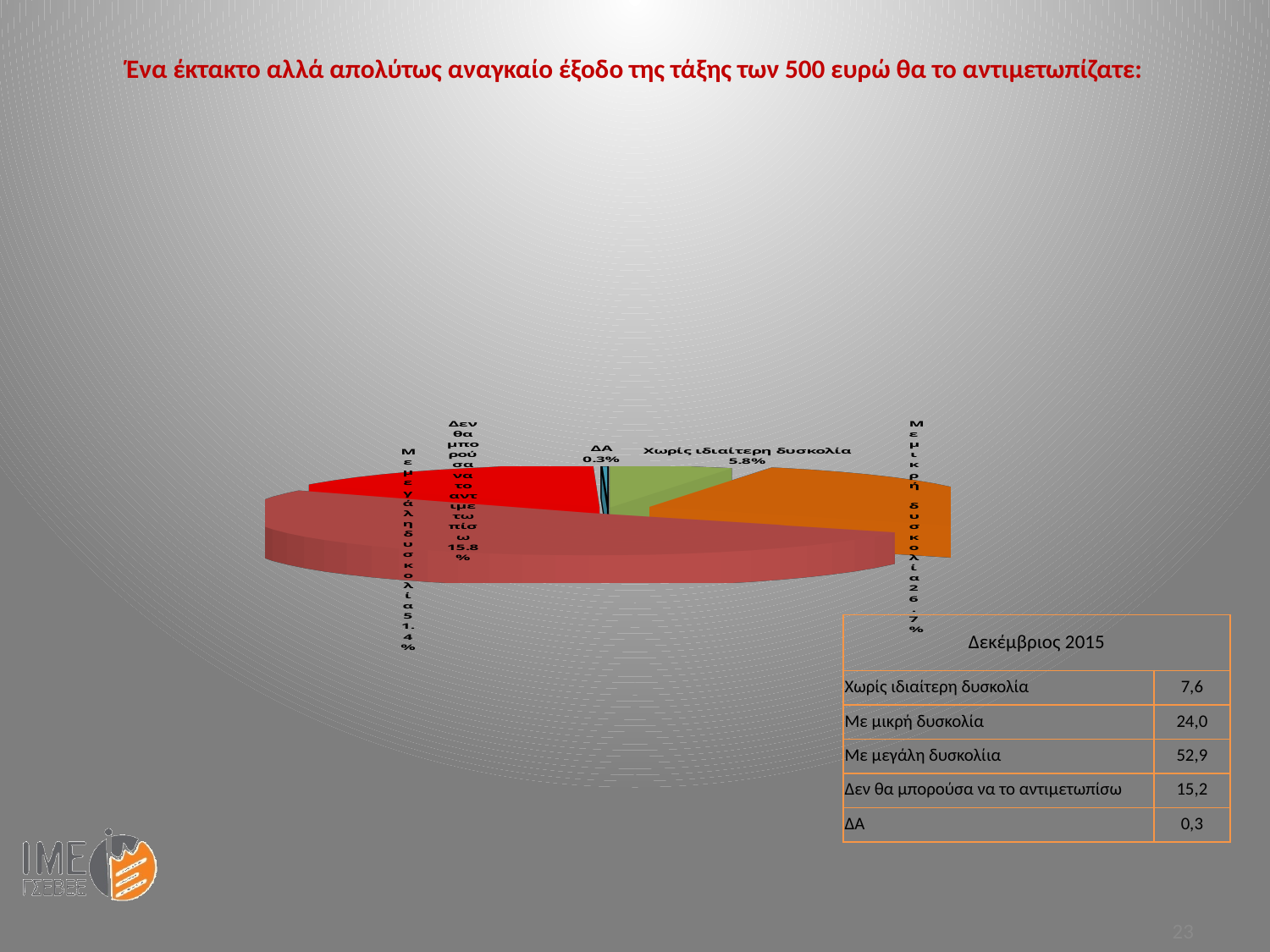
How many slices does the pie chart have? 5 What share of the pie does "Με μεγάλη δυσκολία" have? 51.4% Which is larger: the share of "Με μικρή δυσκολία" or the share of "Δεν θα μπορούσα να το αντιμετωπίσω"? Με μικρή δυσκολία What kind of chart is shown on the slide? pie chart What share of the pie does "Δεν θα μπορούσα να το αντιμετωπίσω" have? 15.8% What share of the pie does "Χωρίς ιδιαίτερη δυσκολία" have? 5.8% Which slice of the pie is the largest? Με μεγάλη δυσκολία What is the difference between the shares of "Με μεγάλη δυσκολία" and "Με μικρή δυσκολία"? 24.7% What colour is the largest slice of the pie chart? red Which slice of the pie is the smallest? ΔΑ